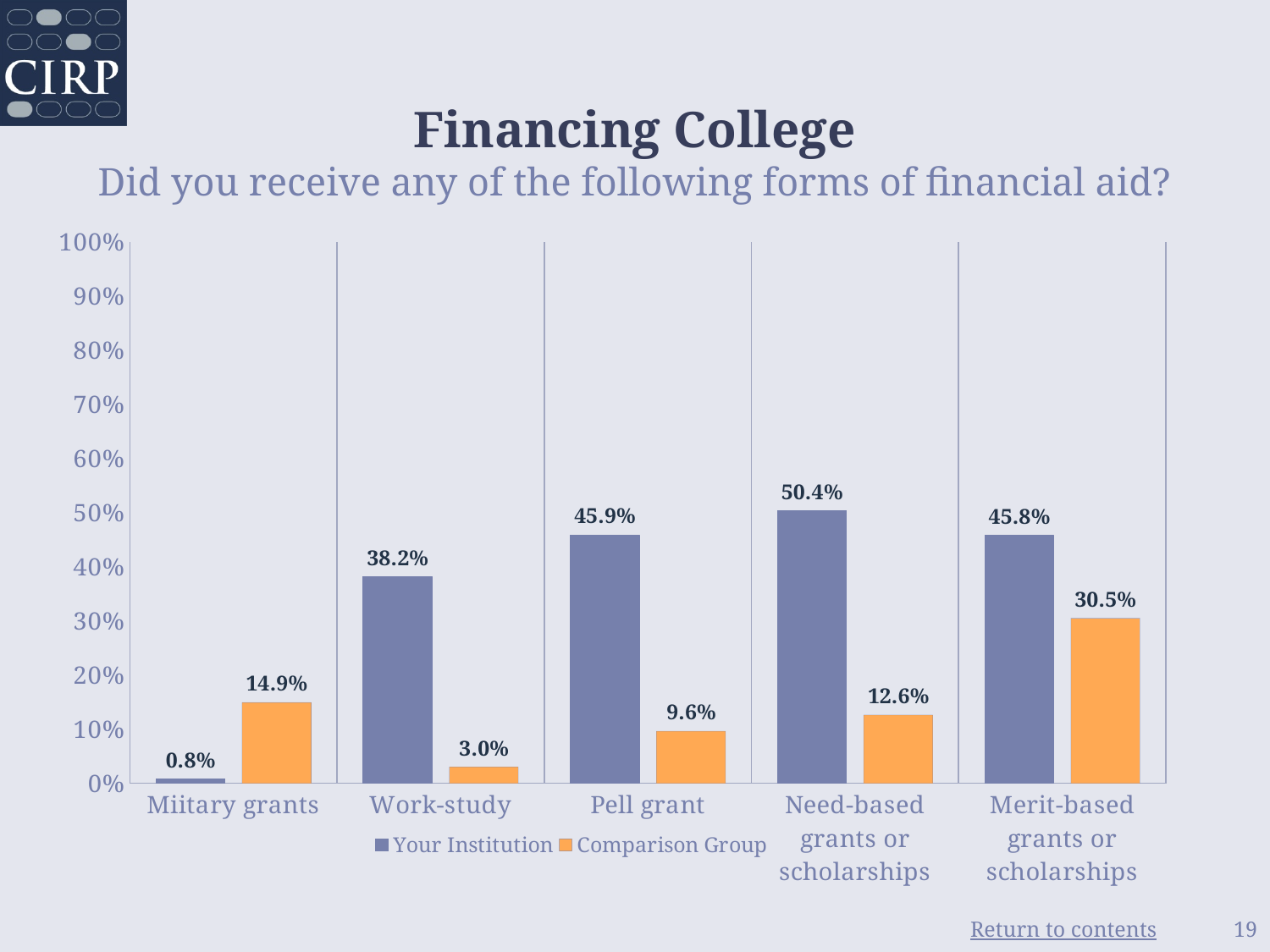
Is the Your Institution value for Work-study greater or less than 40%? less What is the difference between Your Institution and the Comparison Group for Need-based grants or scholarships? 37.8% What percentage of Your Institution received a Pell grant? 45.9% How many series does the legend list? 2 What is the Comparison Group value for Merit-based grants or scholarships? 30.5% Which category has the highest value for Your Institution? Need-based grants or scholarships Which category has the lowest value for the Comparison Group? Work-study What colour are the Comparison Group bars? orange What is the Comparison Group value for Work-study? 3.0% What kind of chart is shown on the slide? bar chart How many categories of financial aid are shown on the x axis? 5 For Military grants, which is larger: Your Institution or the Comparison Group? Comparison Group